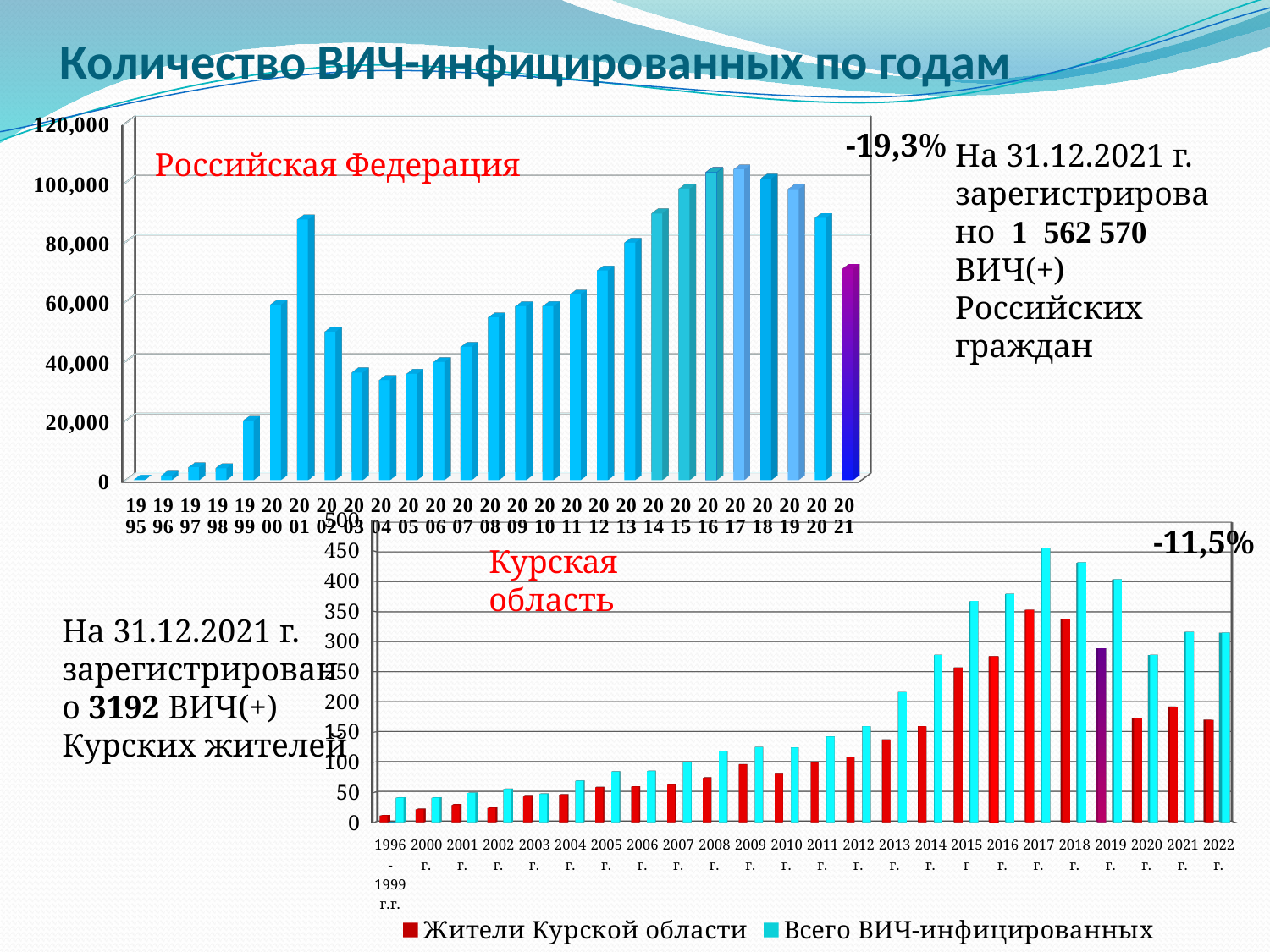
In the "Российская Федерация" chart, is the value for 2001 greater or less than 80,000? greater In the "Курская область" chart, is the "Всего ВИЧ-инфицированных" value for 2017 greater or less than 400? greater What percentage change is annotated at the top right of the "Курская область" chart? -11,5% In the "Российская Федерация" chart, which year has the lowest value? 1995 In the "Курская область" chart, which year has the highest value for "Всего ВИЧ-инфицированных"? 2017 What kind of chart is the "Российская Федерация" chart at the top of the slide? bar chart In the "Курская область" chart, is the "Жители Курской области" value for 2019 greater or less than 250? greater How many series does the legend of the "Курская область" chart list? 2 In the "Российская Федерация" chart, do the values rise or fall from 2017 to 2021? fall In the "Российская Федерация" chart, which is larger: the value for 2001 or the value for 2002? 2001